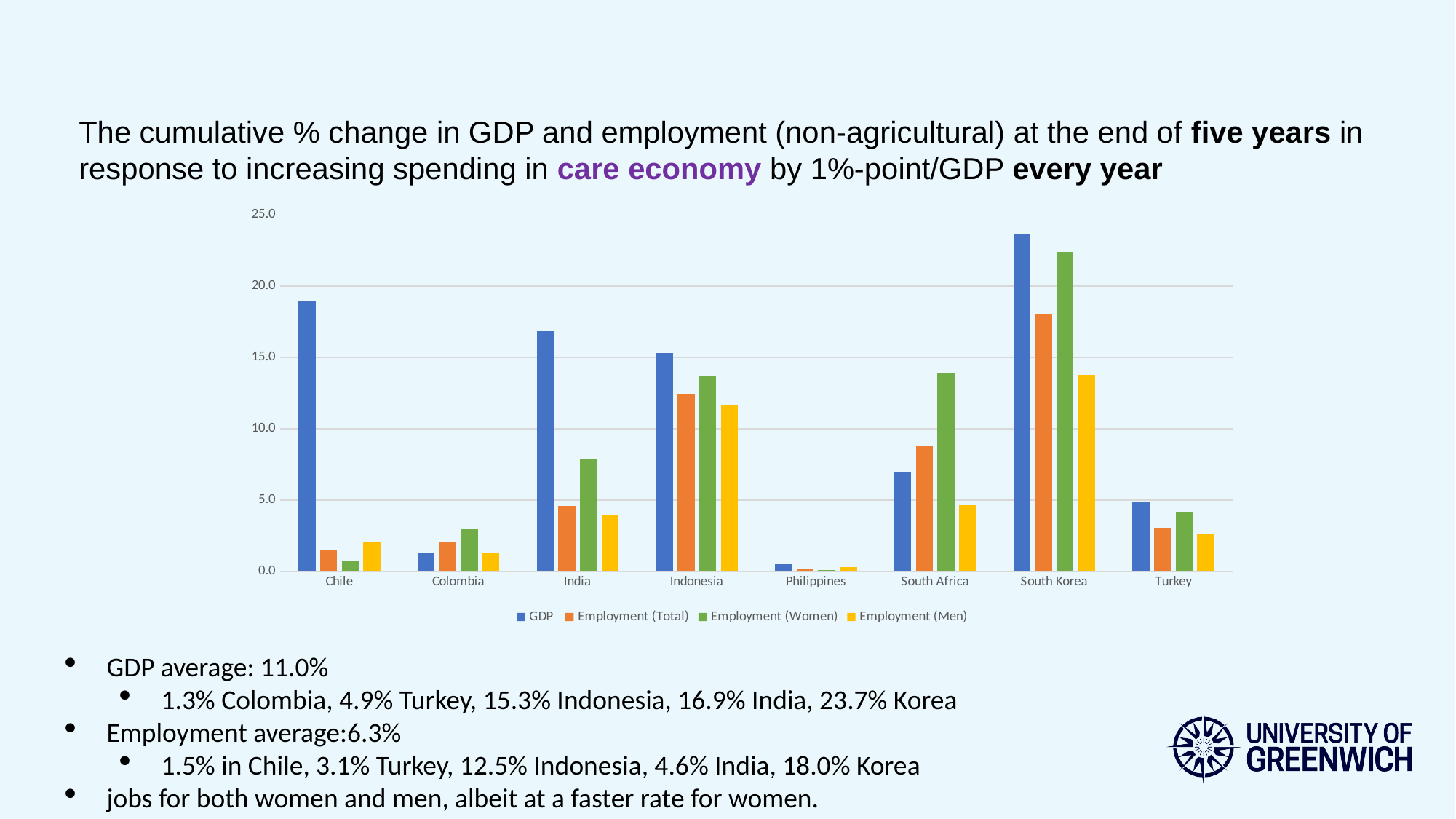
How many countries are shown on the x axis of the chart? 8 Is the GDP value for Chile greater or less than 15.0? greater What is the GDP value for Indonesia? 15.3% What is the difference between the GDP values for India and Indonesia? 1.6% What is the Employment (Total) value for South Korea? 18.0% Which country has the lowest GDP value in the chart? Philippines Is the Employment (Women) value for South Africa greater or less than 10.0? greater What colour represents Employment (Men) in the chart's legend? Yellow Which country has the highest GDP value in the chart? South Korea For Chile, which is larger: the GDP bar or the Employment (Women) bar? GDP What kind of chart is shown on the slide? Bar chart How many series does the chart's legend list? 4